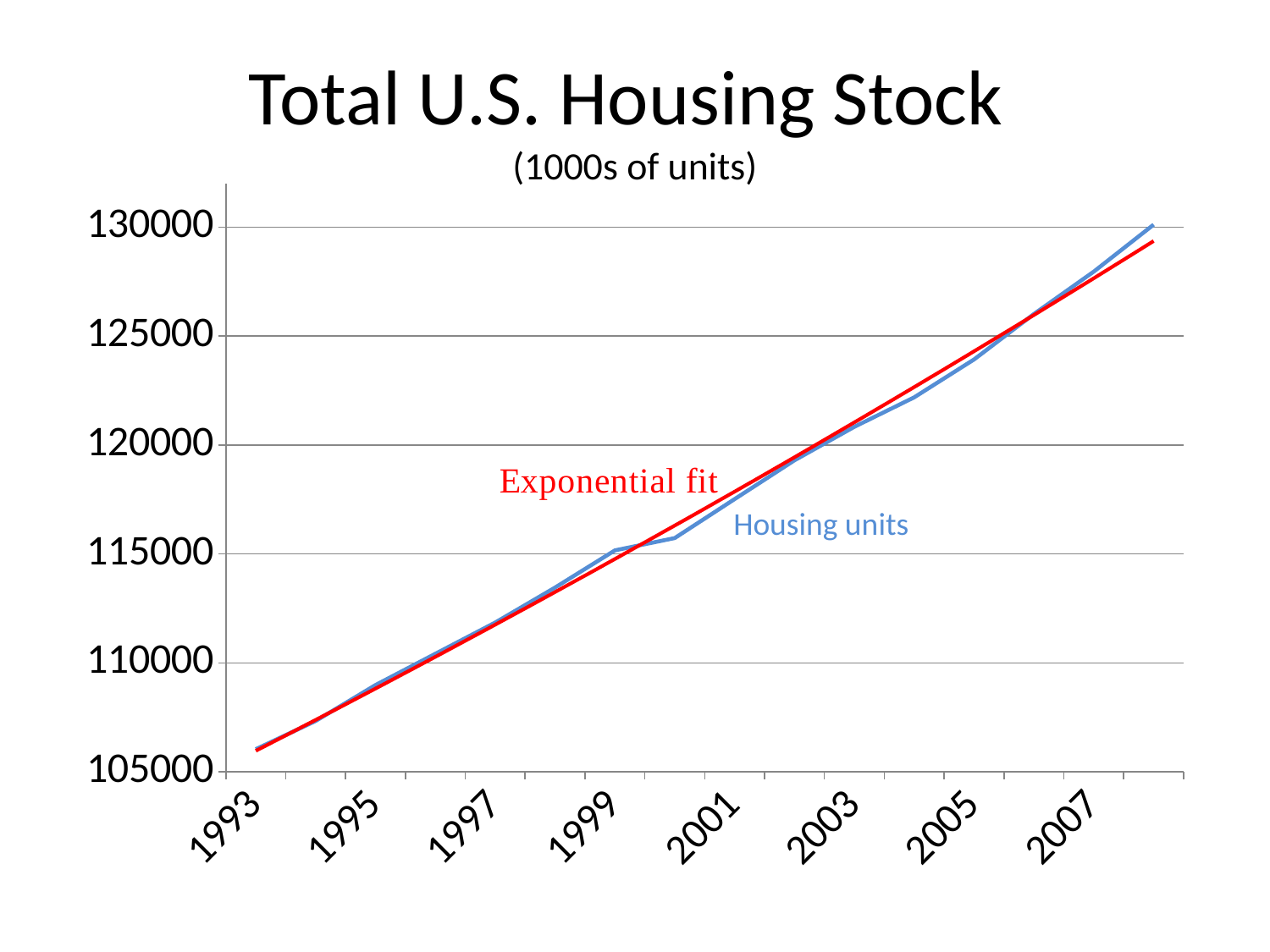
How many lines (series) are plotted on the chart? 2 Does the Housing units line rise or fall from 1993 to 2007? rise In 2005, which line is higher, Housing units or Exponential fit? Exponential fit What kind of chart is shown on the slide? line chart Which year labelled on the x axis has the lowest Housing units value? 1993 Is the value of Housing units in 1993 greater or less than 110000? less Is the value of Housing units in 1997 greater or less than 110000? greater In what units are the values on the chart expressed, according to the subtitle? 1000s of units Is the value of Housing units in 2007 greater or less than 125000? greater What is the title of the chart? Total U.S. Housing Stock How many year labels are shown on the x axis? 8